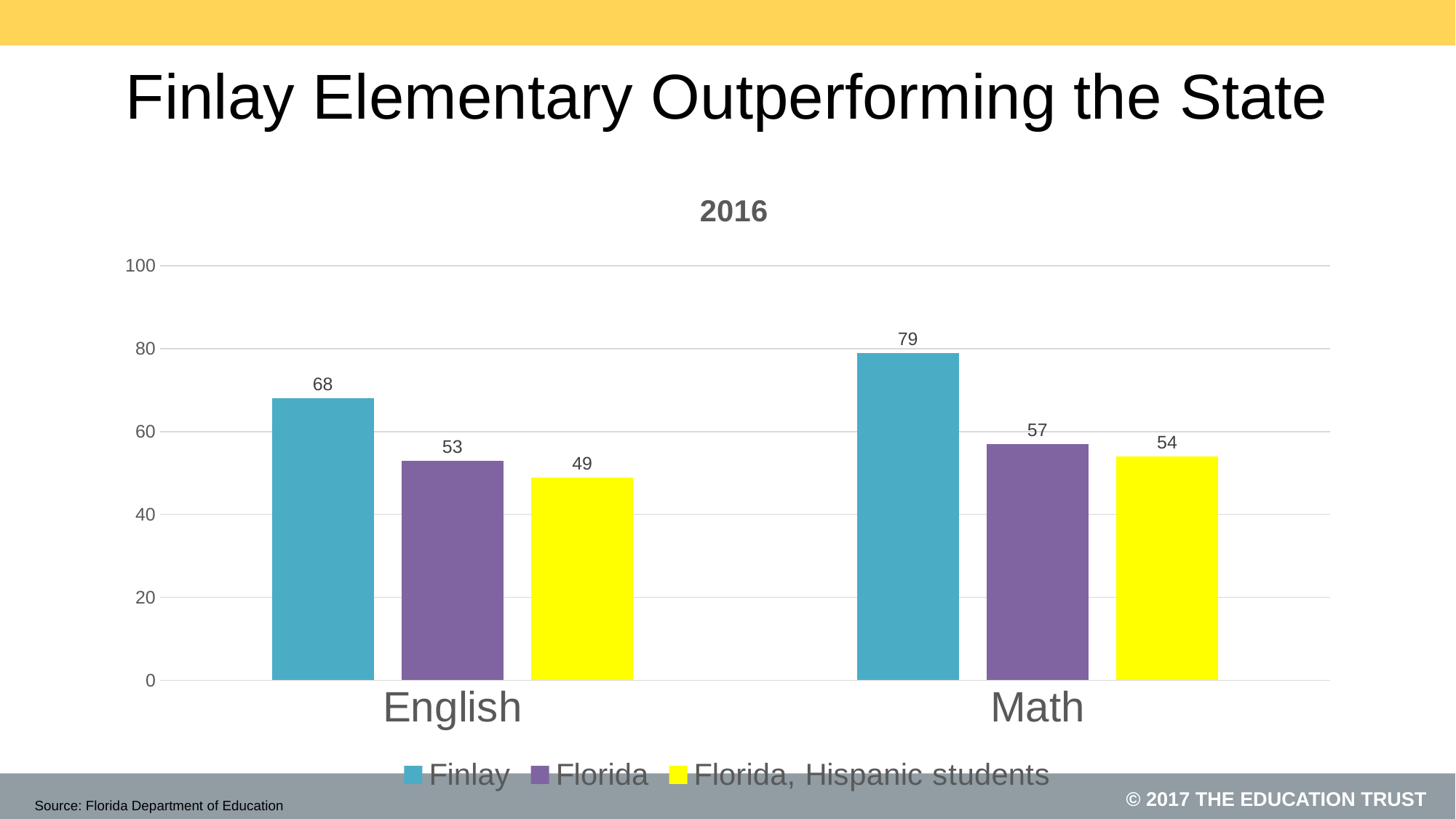
Which series has the highest value in Math? Finlay What is the difference between Finlay and Florida in Math? 22 How many series does the legend list? 3 Which is larger: Finlay in English or Finlay in Math? Finlay in Math How many categories are shown on the x axis? 2 Which series has the lowest value in English? Florida, Hispanic students What is the value for Florida, Hispanic students in Math? 54 What is the difference between Florida and Florida, Hispanic students in English? 4 What is the value for Florida in Math? 57 What is the value for Finlay in English? 68 Is the value for Finlay in Math greater or less than 60? greater What kind of chart is shown on the slide? Bar chart